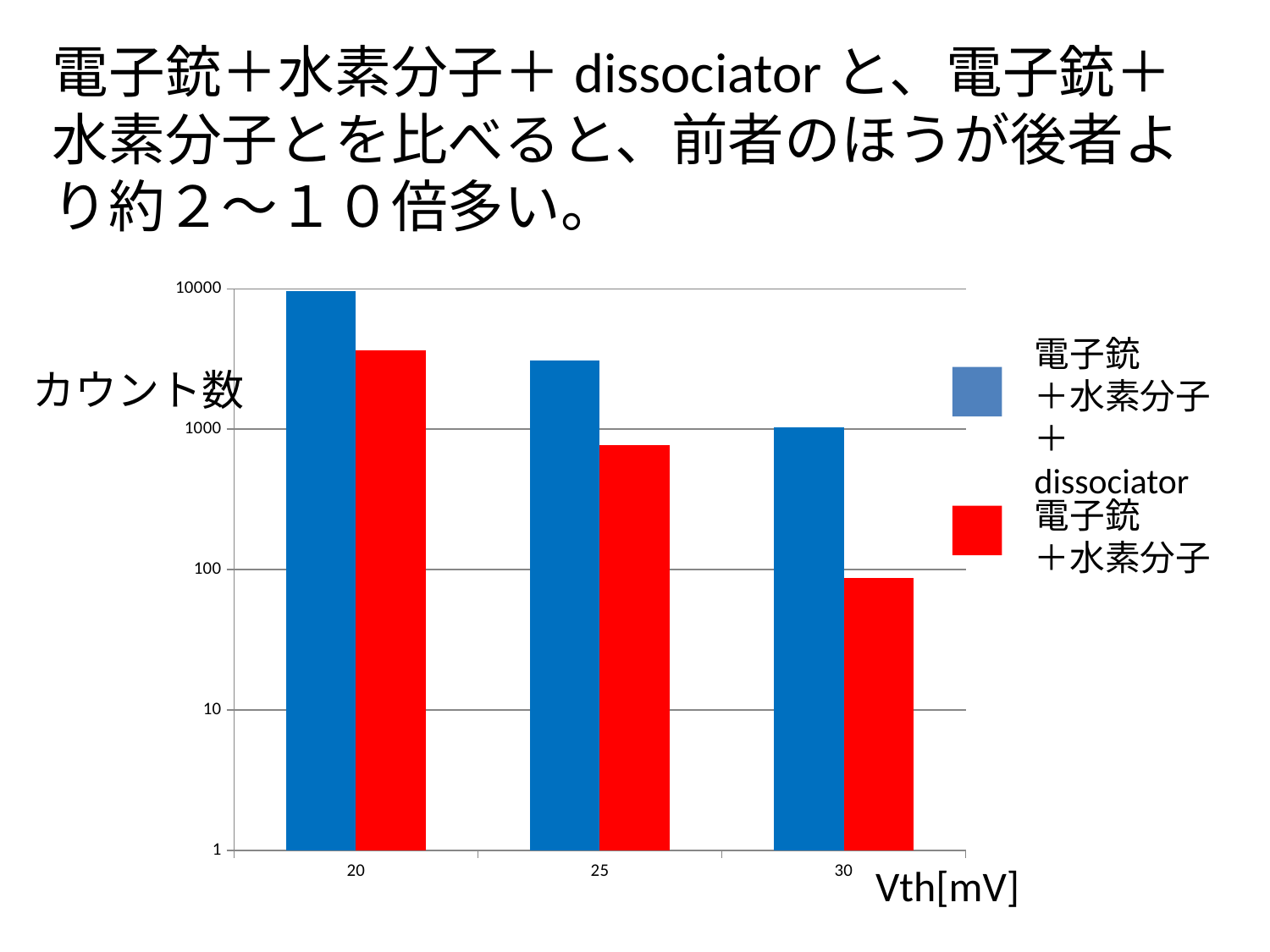
What is the label of the x axis? Vth[mV] Is the count for 電子銃＋水素分子 at Vth = 30 greater or less than 100? less Which series is shown in blue? 電子銃＋水素分子＋dissociator Is the count for 電子銃＋水素分子＋dissociator at Vth = 20 greater or less than 1000? greater How many Vth[mV] categories are shown on the x axis? 3 Do the counts for the 電子銃＋水素分子 series rise or fall as Vth increases from 20 to 30? fall What kind of chart is shown on the slide? bar chart At which Vth value is the 電子銃＋水素分子＋dissociator count highest? 20 Do the counts for the 電子銃＋水素分子＋dissociator series rise or fall as Vth increases from 20 to 30? fall At Vth = 25, which series has the larger count, 電子銃＋水素分子＋dissociator or 電子銃＋水素分子? 電子銃＋水素分子＋dissociator At which Vth value is the 電子銃＋水素分子 count lowest? 30 How many series does the legend list? 2